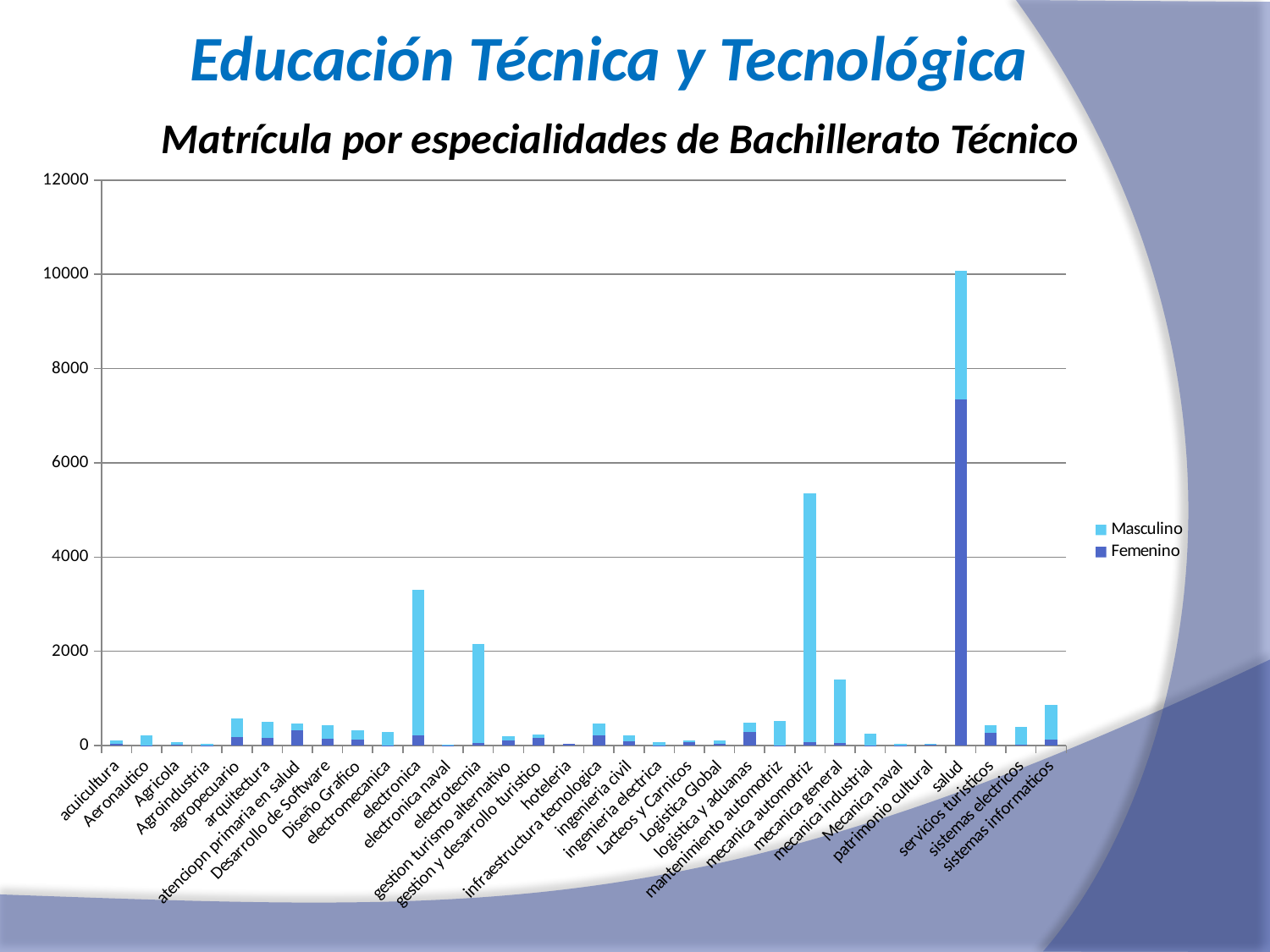
Is the total value for electronica greater or less than 2000? greater Is the Femenino value for salud greater or less than 6000? greater How many specialties (categories) are shown on the x axis? 32 Which two series are listed in the legend? Masculino and Femenino Which has a larger total, mecanica automotriz or mecanica general? mecanica automotriz How many series does the legend list? 2 Is the total value for salud greater or less than 8000? greater What kind of chart is shown on the slide? bar chart Which has a larger total, electronica or electrotecnia? electronica What is the title of the chart? Matrícula por especialidades de Bachillerato Técnico Which specialty has the highest total enrollment? salud